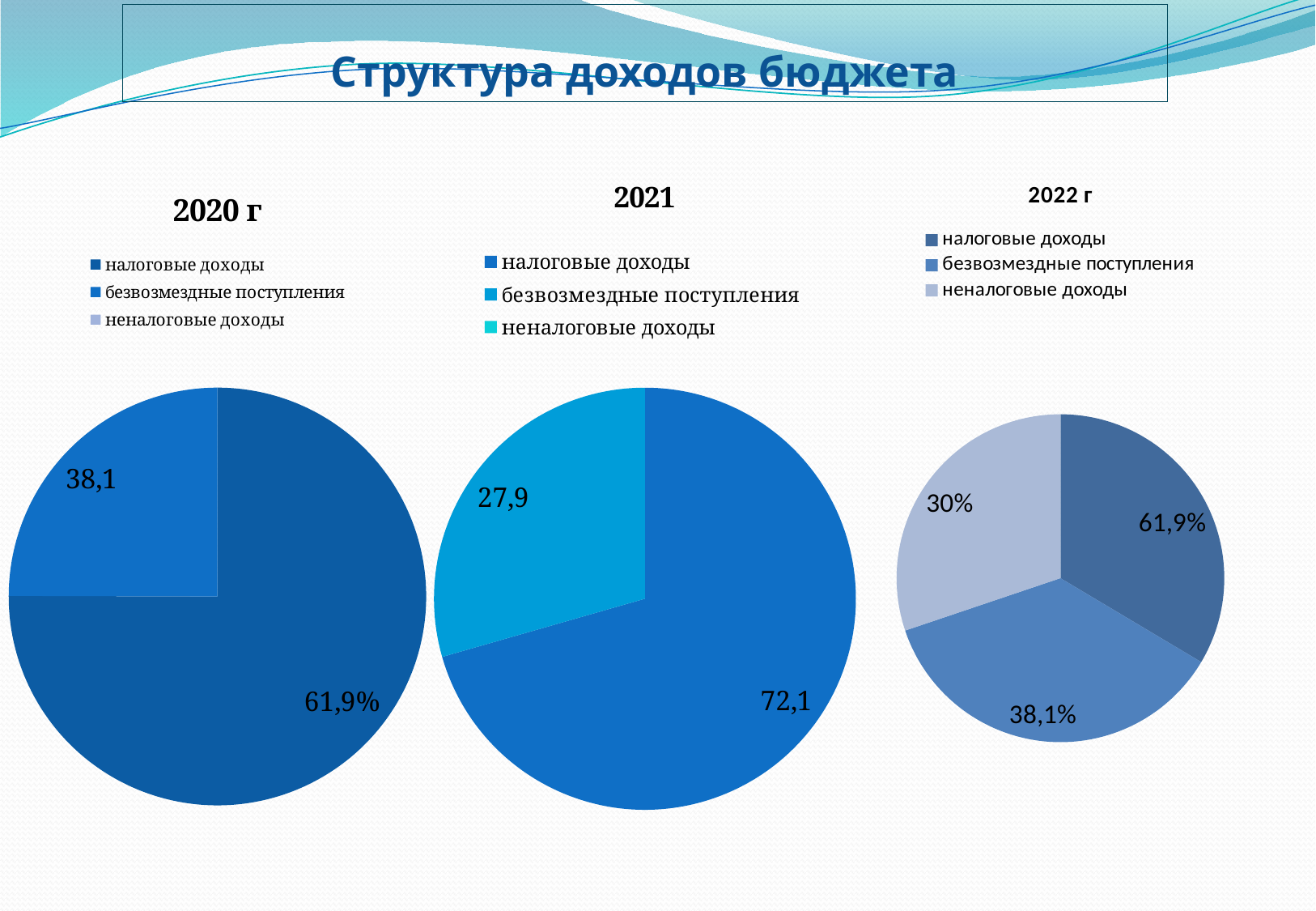
What is the title of the slide containing the three pie charts? Структура доходов бюджета In the 2021 pie chart, which category has the largest slice? налоговые доходы What type of chart is used for the 2022 г data? pie chart In the 2022 г pie chart, what value is shown for безвозмездные поступления? 38,1% How many entries does the legend of the 2021 chart list? 3 In the 2021 pie chart, what value is shown for безвозмездные поступления? 27,9 In the 2021 pie chart, what is the difference between the values for налоговые доходы and безвозмездные поступления? 44,2 In the 2020 г pie chart, what value is shown for безвозмездные поступления? 38,1 In the 2021 pie chart, what value is shown for налоговые доходы? 72,1 In the 2020 г pie chart, which of the two labelled slices is larger, налоговые доходы or безвозмездные поступления? налоговые доходы In the 2020 г pie chart, what value is shown for налоговые доходы? 61,9% In the 2022 г pie chart, what value is shown for неналоговые доходы? 30%